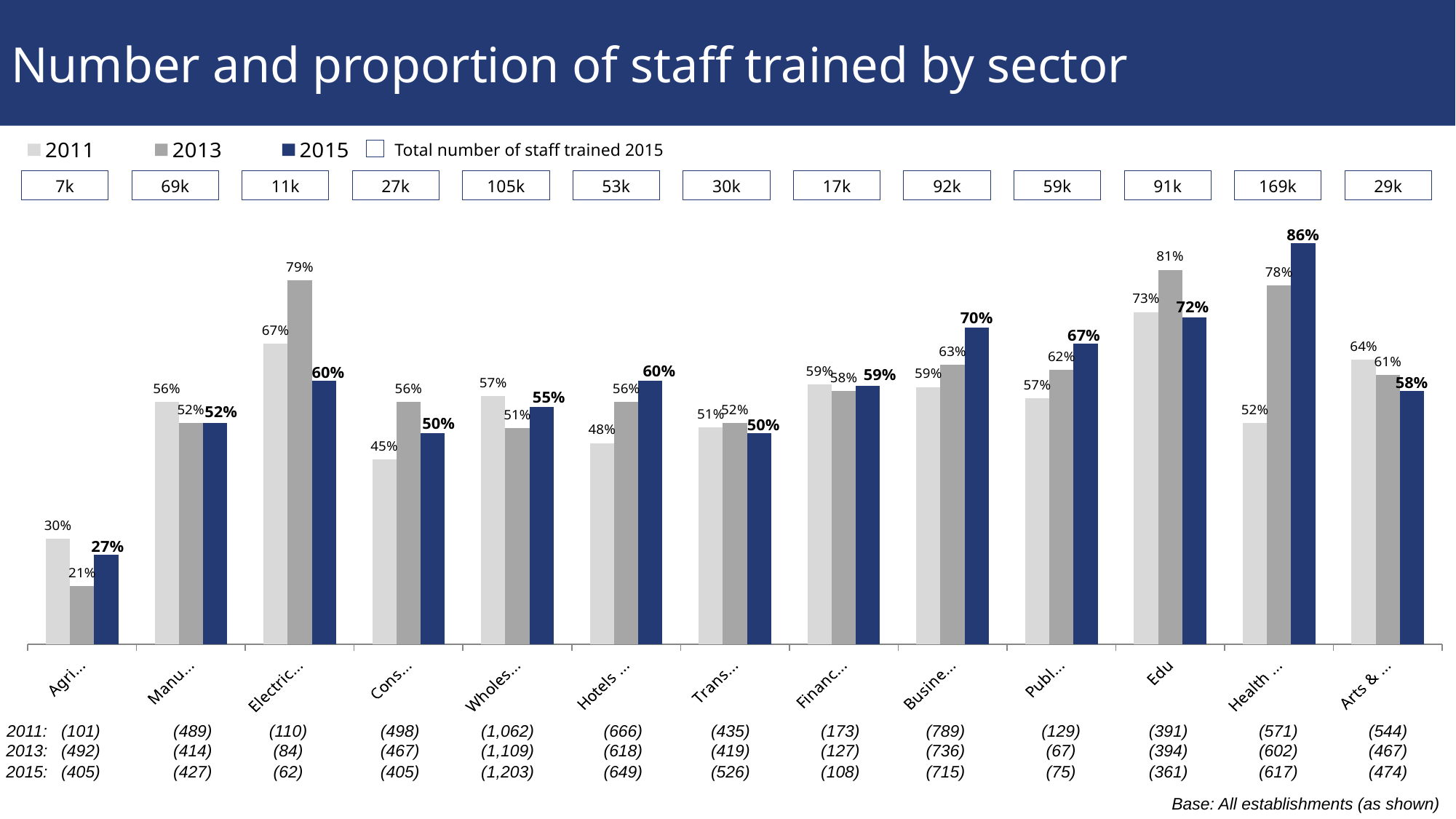
What is the 2015 value for the Edu category? 72% Which category has the lowest 2015 value? Agri... What is the title of the chart? Number and proportion of staff trained by sector Do the values for the Busine... category rise or fall from 2011 to 2015? Rise Which category has the highest 2015 value? Health ... Which is larger: the 2013 value for Electric... or the 2013 value for Edu? Edu What is the 2013 value for the Cons... category? 56% What is the difference between the 2015 and 2011 values for the Health ... category? 34 percentage points What kind of chart is shown on the slide? Bar chart How many sector categories are shown on the x axis? 13 What is the total number of staff trained in 2015 shown in the box above the Health ... category? 169k How many year series (2011, 2013, 2015) does the legend list? 3